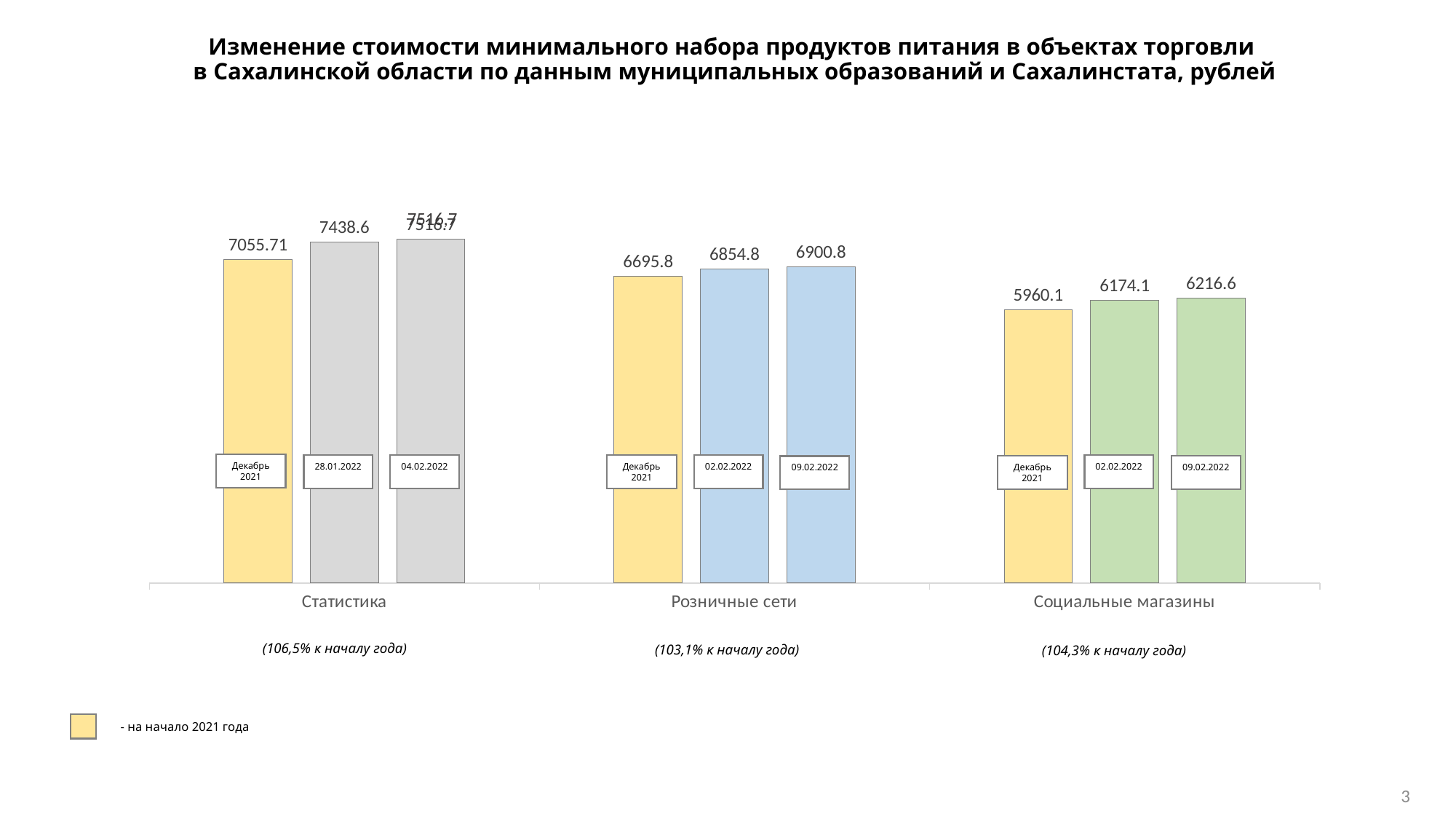
What is the value for 09.02.2022 in the Розничные сети group? 6900.8 What is the difference between the 02.02.2022 and Декабрь 2021 values in the Розничные сети group? 159 Do the values in the Социальные магазины group rise or fall from Декабрь 2021 to 09.02.2022? rise What is the value for 28.01.2022 in the Статистика group? 7438.6 What is the value for 02.02.2022 in the Социальные магазины group? 6174.1 What is the value for Декабрь 2021 in the Социальные магазины group? 5960.1 What kind of chart is shown on the slide? bar chart What is the value for Декабрь 2021 in the Статистика group? 7055.71 How many groups of bars are shown on the x axis? 3 Which is larger: the 09.02.2022 value for Розничные сети or the 09.02.2022 value for Социальные магазины? Розничные сети Which group has the lowest Декабрь 2021 value? Социальные магазины Which group has the highest Декабрь 2021 value? Статистика